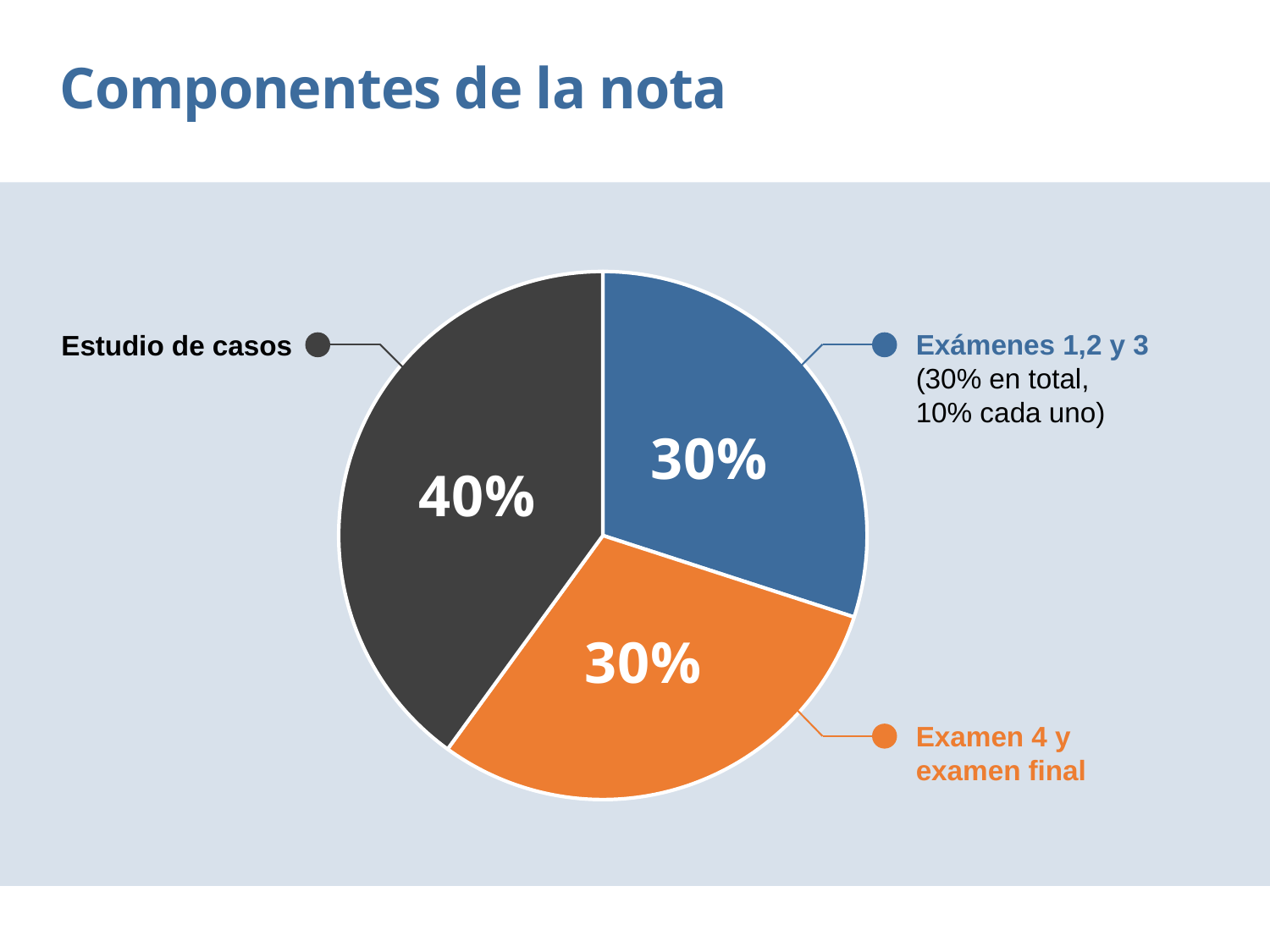
What kind of chart is shown on the slide? pie chart Which is larger, the share for Estudio de casos or the share for Examen 4 y examen final? Estudio de casos How many slices does the pie chart have? 3 What share of the pie does Exámenes 1,2 y 3 represent? 30% What is the difference between the share for Estudio de casos and the share for Exámenes 1,2 y 3? 10% What colour is the slice for Examen 4 y examen final? orange According to the label, what percentage does each of Exámenes 1,2 y 3 count for individually? 10% What is the title of the chart? Componentes de la nota Which component has the largest share of the pie? Estudio de casos What share of the pie does Estudio de casos represent? 40% Is the share for Estudio de casos greater or less than 50%? less What share of the pie does Examen 4 y examen final represent? 30%